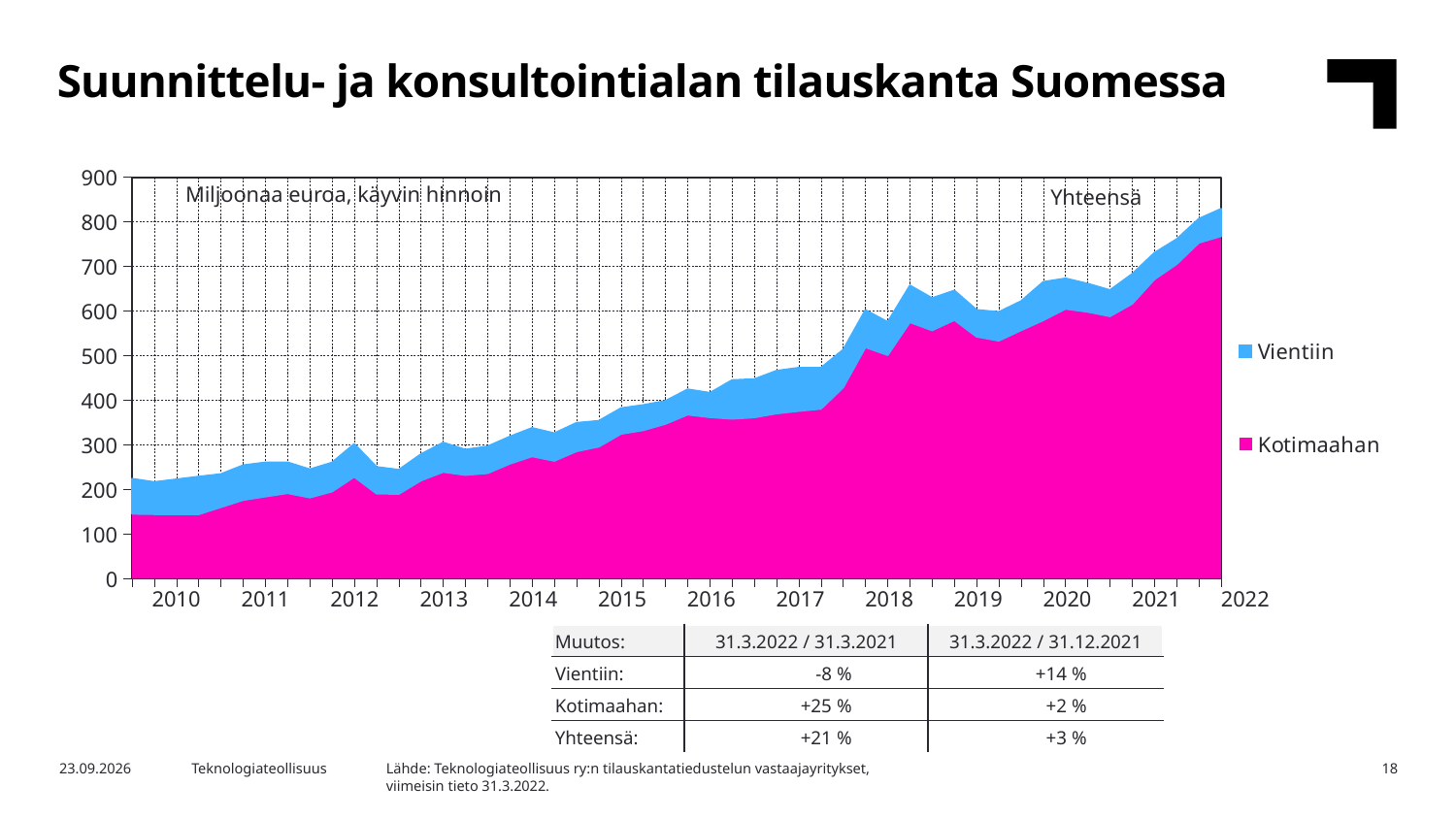
Is the Kotimaahan value at the end of the series in 2022 greater or less than 700? greater What unit is stated in the label inside the chart area? Miljoonaa euroa, käyvin hinnoin At the end of the series in 2022, which series is larger, Vientiin or Kotimaahan? Kotimaahan Is the total (Yhteensä) value at the end of the series in 2022 greater or less than 800? greater What kind of chart is shown on the slide? Stacked area chart How many year labels are shown on the x axis? 13 How many series does the chart legend list? 2 Is the Kotimaahan value at the start of 2010 greater or less than 200? less According to the table below the chart, what is the change in Vientiin for 31.3.2022 / 31.3.2021? -8 % Does the total order backlog (Yhteensä) generally rise or fall from 2010 to 2022? Rise Which two series are listed in the chart legend? Vientiin and Kotimaahan